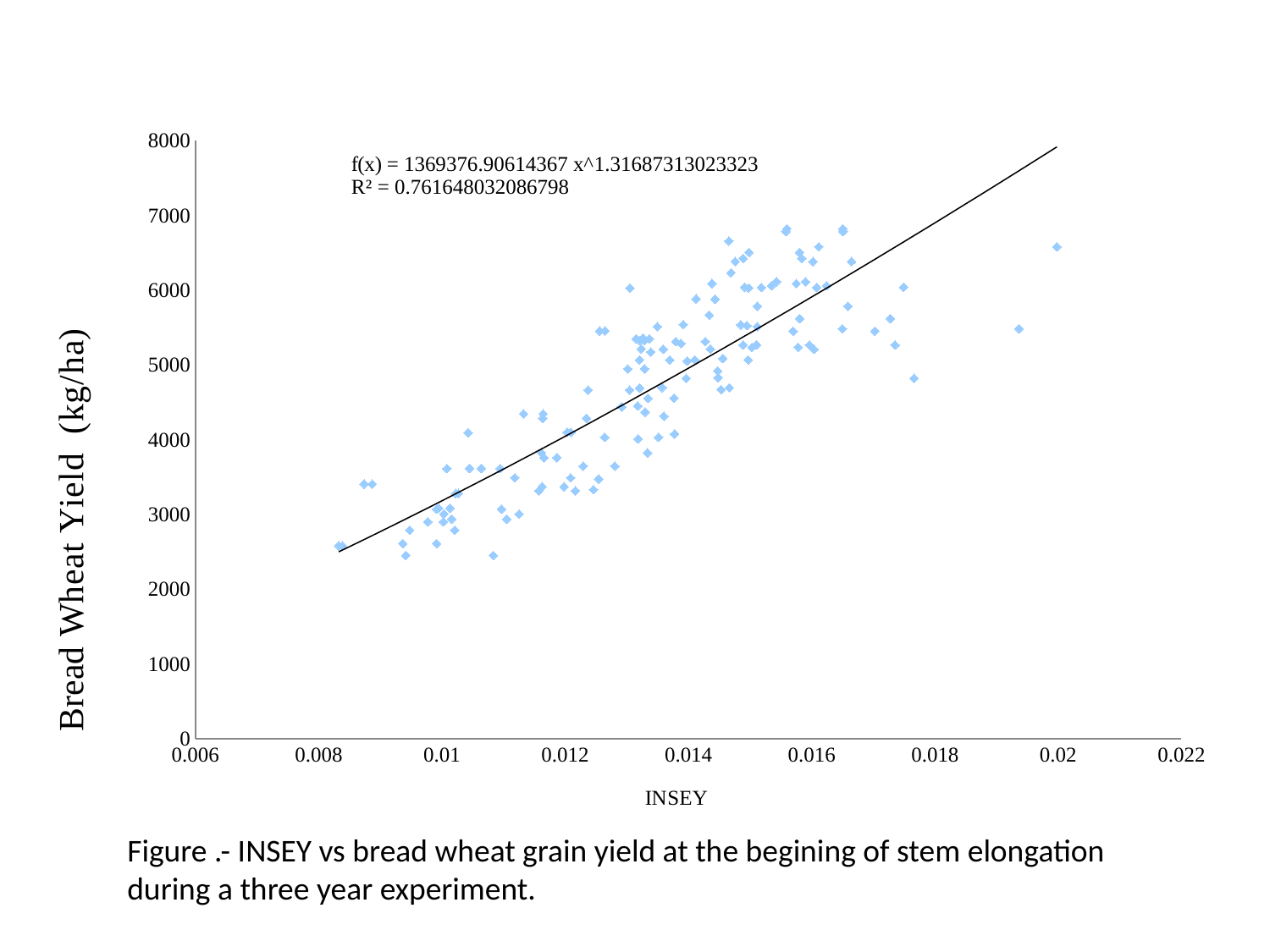
Do the plotted yield values generally rise or fall as INSEY increases along the x axis? rise Is the lowest plotted yield value greater or less than 3000 kg/ha? less Is the highest plotted yield value greater or less than 7000 kg/ha? less What kind of chart is shown on the slide? scatter chart What is the highest tick value shown on the x axis? 0.022 What R² value is printed on the chart? 0.761648032086798 What is the label of the x axis? INSEY What is the exponent of x in the fitted equation printed on the chart? 1.31687313023323 What is the highest tick value shown on the y axis? 8000 Is the yield of the point with the largest INSEY value (near 0.02) greater or less than 6000 kg/ha? greater What is the label of the y axis? Bread Wheat Yield (kg/ha)